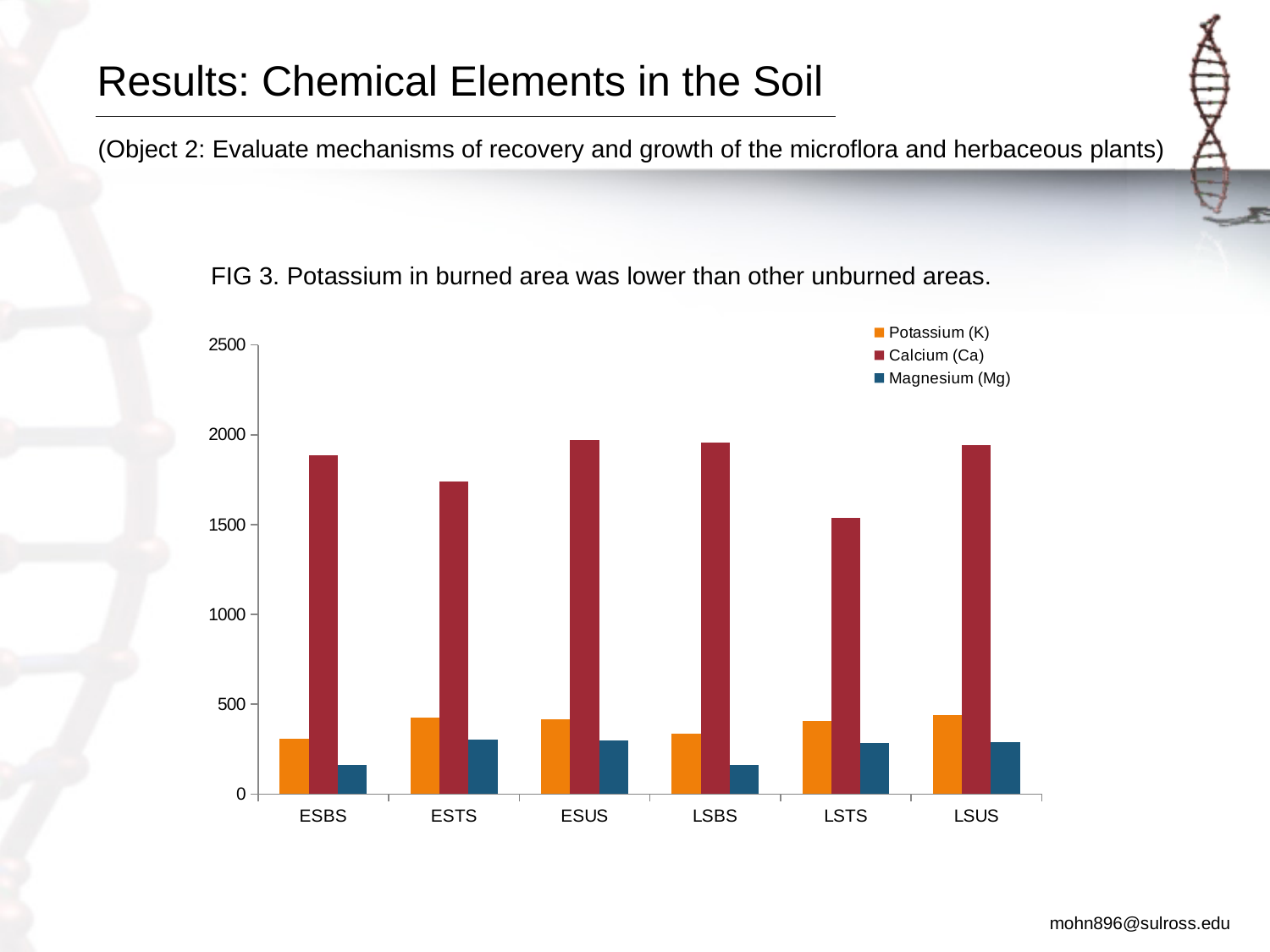
Is the Calcium (Ca) value for ESBS greater or less than 1500? greater In the ESBS category, which is larger, the Potassium (K) value or the Magnesium (Mg) value? Potassium (K) Which series is shown in orange in the chart? Potassium (K) Is the Calcium (Ca) value for LSTS greater or less than 2000? less Is the Potassium (K) value for LSUS greater or less than 500? less Which is larger, the Calcium (Ca) value for ESTS or for LSTS? ESTS How many categories are shown along the x axis of the chart? 6 Which category has the lowest Calcium (Ca) value? LSTS How many series does the chart's legend list? 3 What kind of chart is shown on the slide? bar chart What is the figure caption shown above the chart? FIG 3. Potassium in burned area was lower than other unburned areas.